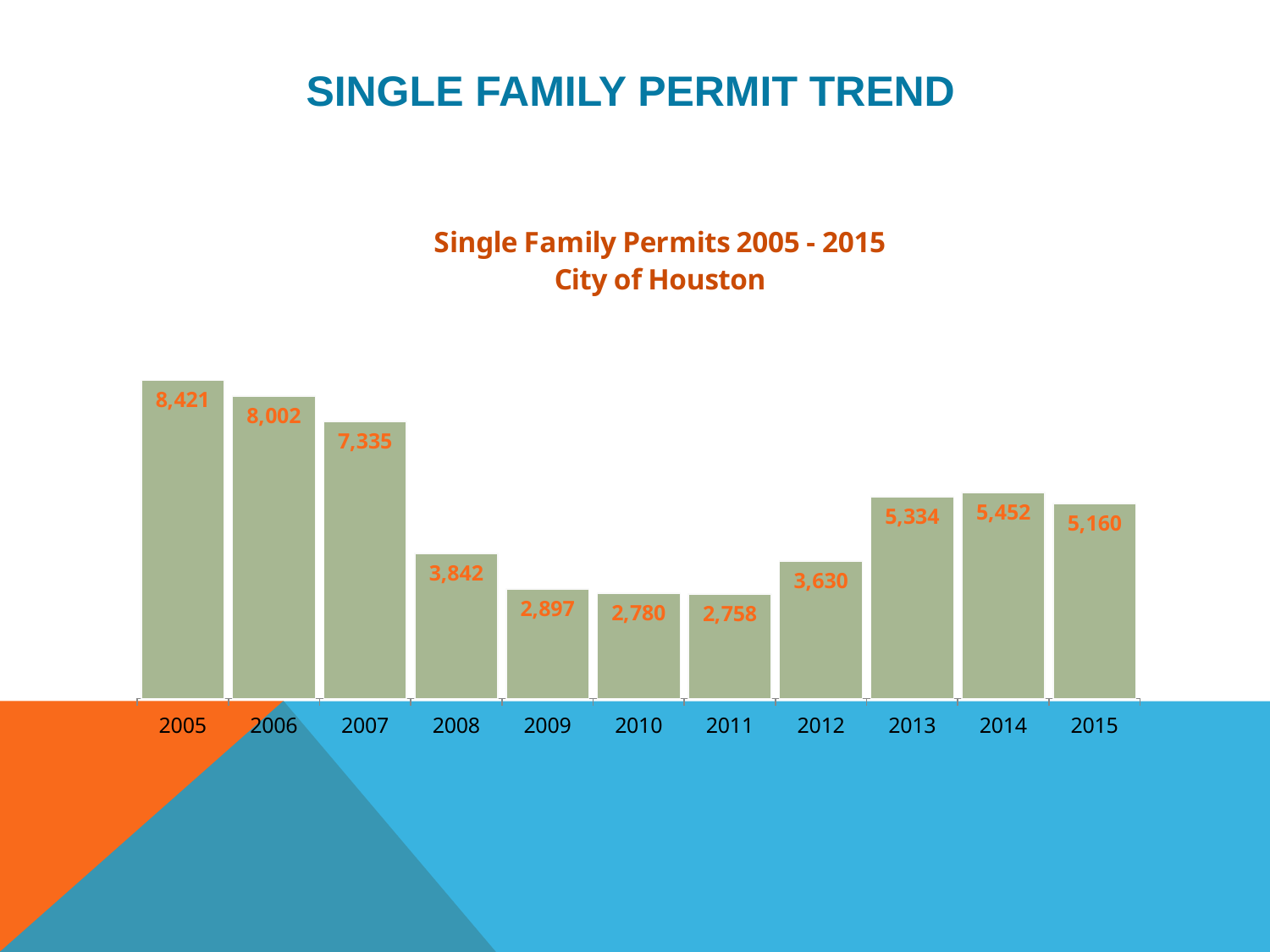
What is the value for 2014? 5,452 Which year has the highest value? 2005 What is the title of the chart? Single Family Permits 2005 - 2015 City of Houston What is the value for 2011? 2,758 How many years are shown on the x axis? 11 What is the difference between the values for 2013 and 2012? 1,704 Which is larger, the value for 2008 or the value for 2012? 2008 Which year has the lowest value? 2011 Do the values rise or fall from 2005 to 2011? fall What is the difference between the values for 2005 and 2006? 419 What kind of chart is shown? bar chart What is the value for 2005? 8,421